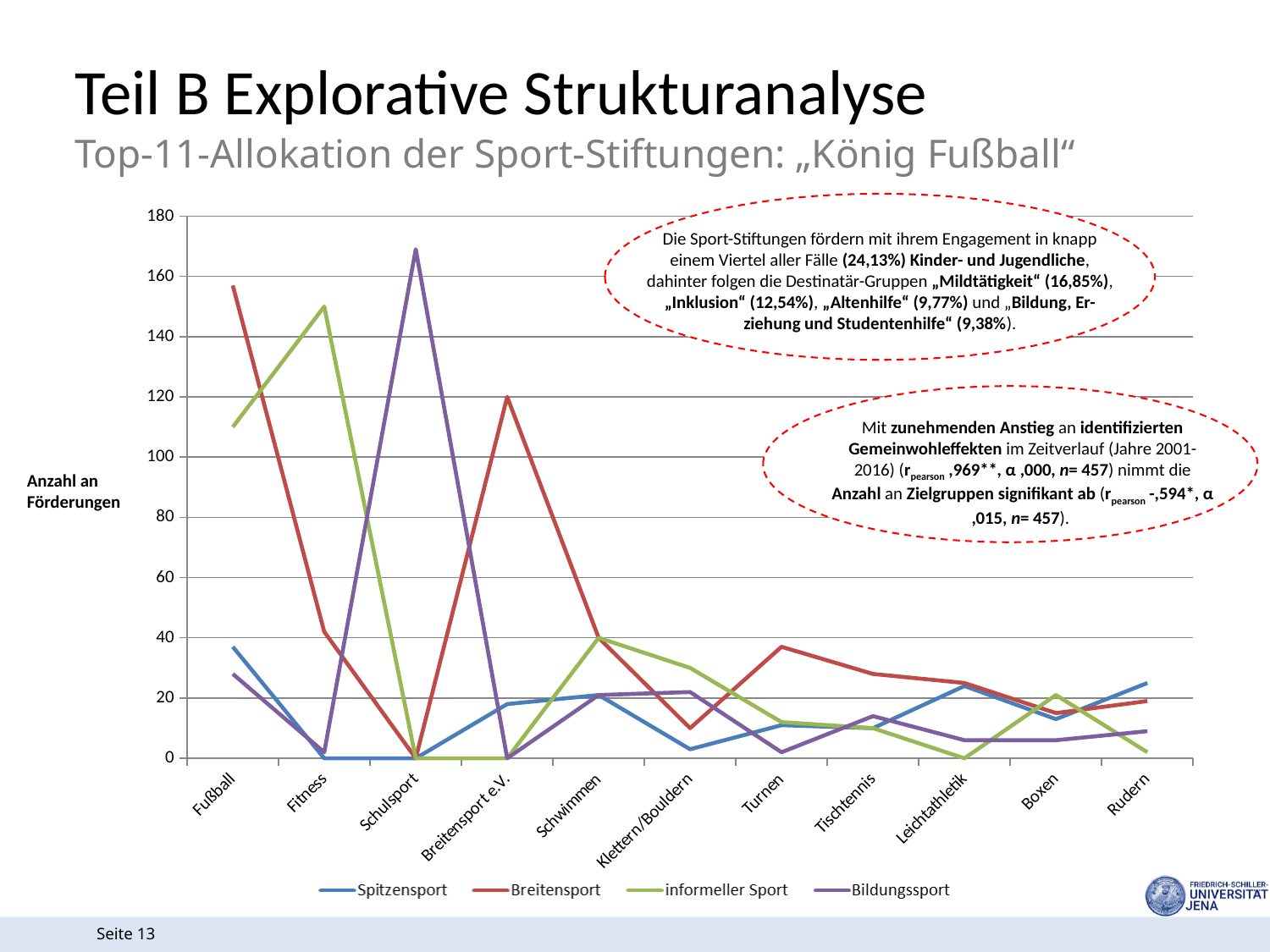
Is the Spitzensport value for Fußball greater or less than 60? less What kind of chart is shown on the slide? line chart In which category does the Breitensport series reach its highest value? Fußball What is the label on the vertical axis of the chart? Anzahl an Förderungen In which category does the informeller Sport series reach its highest value? Fitness Is the Bildungssport value for Schulsport greater or less than 160? greater How many categories are shown along the x axis of the chart? 11 In which category does the Bildungssport series reach its highest value? Schulsport Is the Breitensport value for Fußball greater or less than 140? greater Does the Breitensport series rise or fall from Fußball to Fitness? fall How many series does the chart's legend list? 4 For the category Turnen, which series has the larger value: Breitensport or informeller Sport? Breitensport